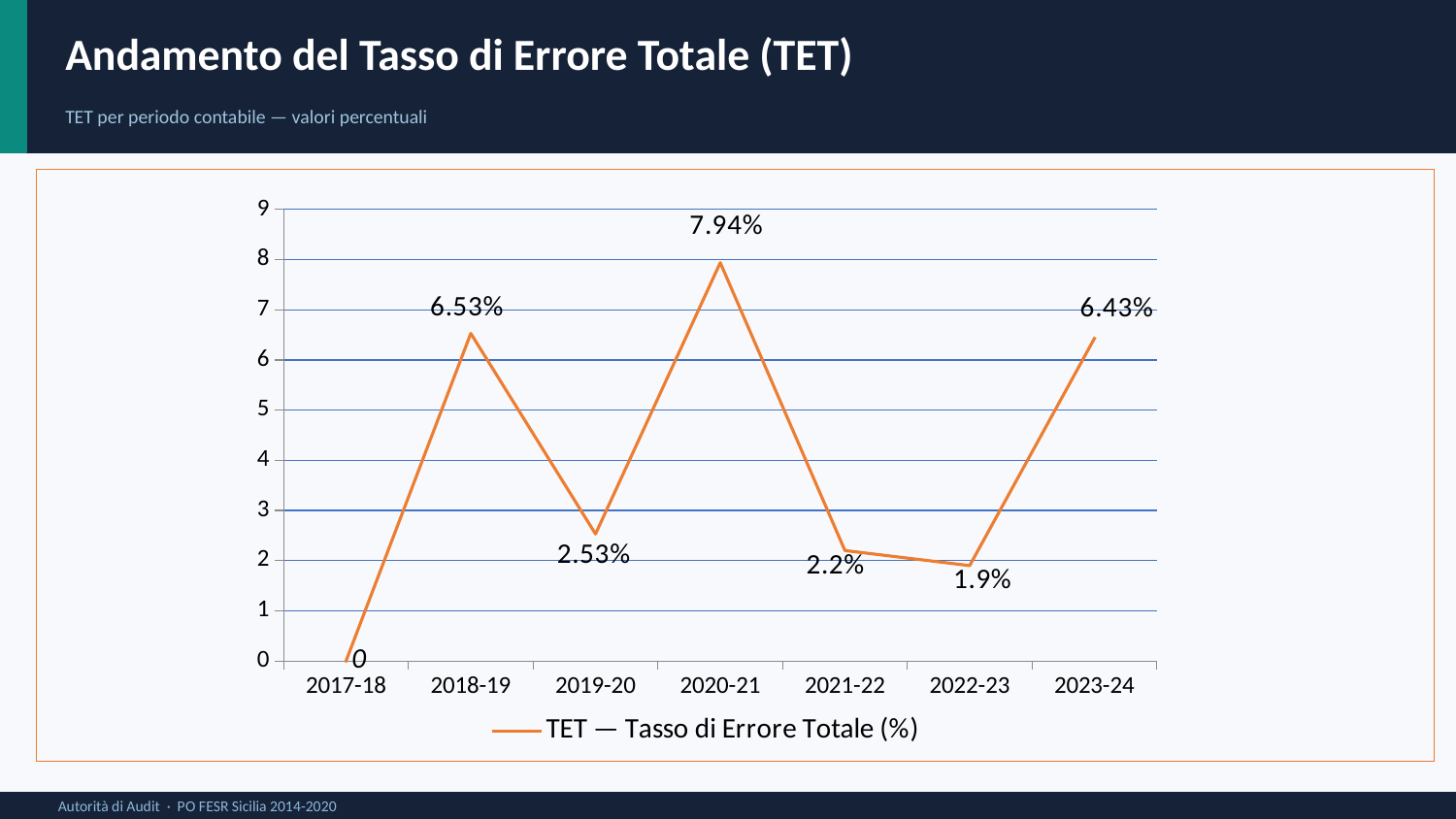
What is the TET value for 2018-19? 6.53% How many periods are plotted on the x axis? 7 Which is larger, the TET value for 2018-19 or for 2023-24? 2018-19 Which period has the lowest TET value? 2017-18 What is the TET value for 2022-23? 1.9% What is the difference between the TET values for 2020-21 and 2019-20? 5.41% Is the TET value for 2021-22 greater or less than 3? less What is the TET value for 2017-18? 0 Which period has the highest TET value? 2020-21 What is the legend entry for the plotted series? TET — Tasso di Errore Totale (%) What kind of chart is shown on the slide? line chart What is the TET value for 2020-21? 7.94%